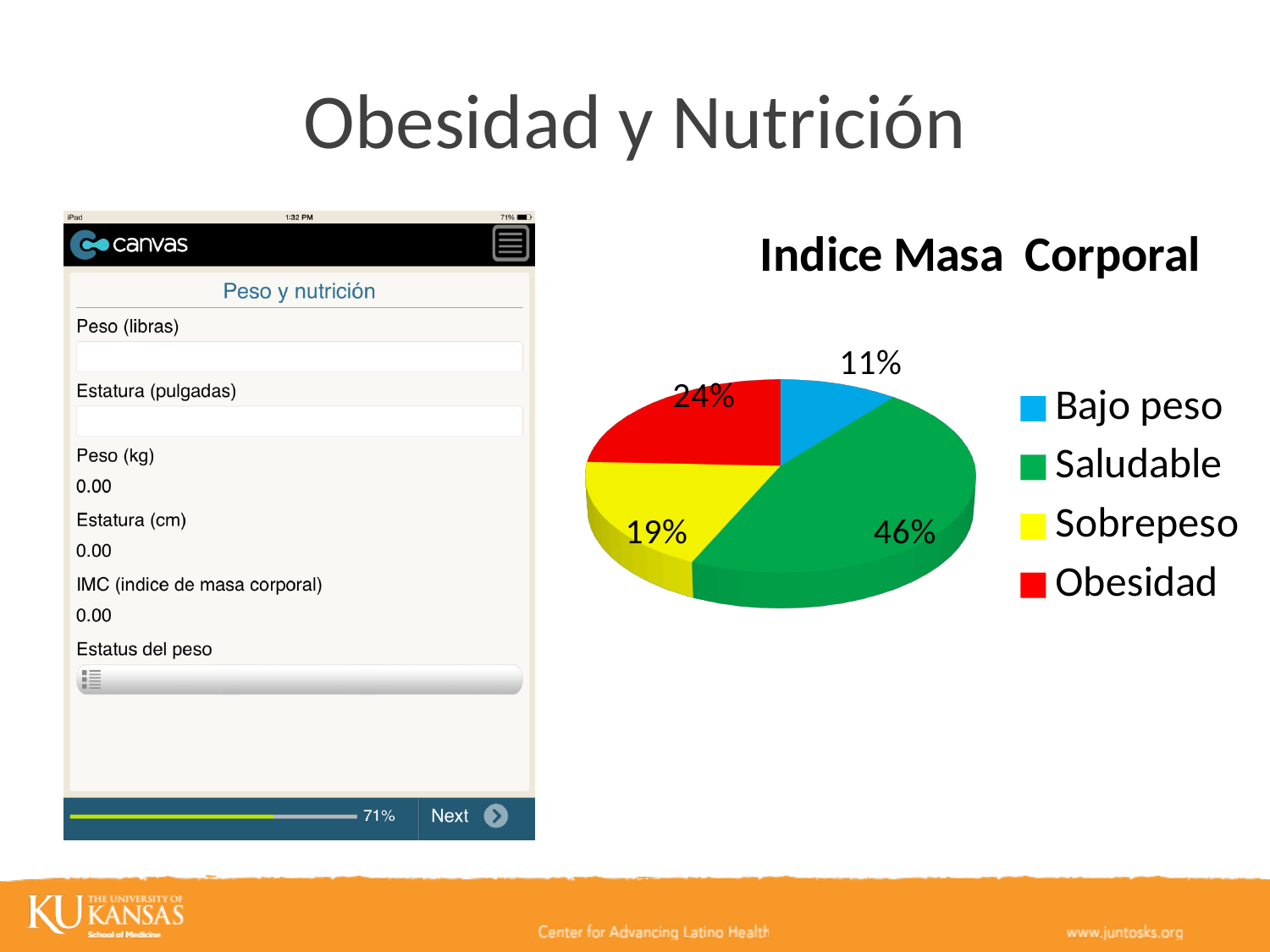
What is the title of the pie chart? Indice Masa Corporal What kind of chart is shown on the slide? pie chart What is the difference in percentage points between Saludable and Obesidad? 22 What percentage of the pie is Sobrepeso? 19% Which colour represents Sobrepeso in the pie chart? yellow Which category has the smallest share of the pie? Bajo peso What percentage of the pie is Saludable? 46% Which category has the largest share of the pie? Saludable How many categories does the pie chart show? 4 Which is larger, the share for Obesidad or the share for Sobrepeso? Obesidad What percentage of the pie is Obesidad? 24% What percentage of the pie is Bajo peso? 11%